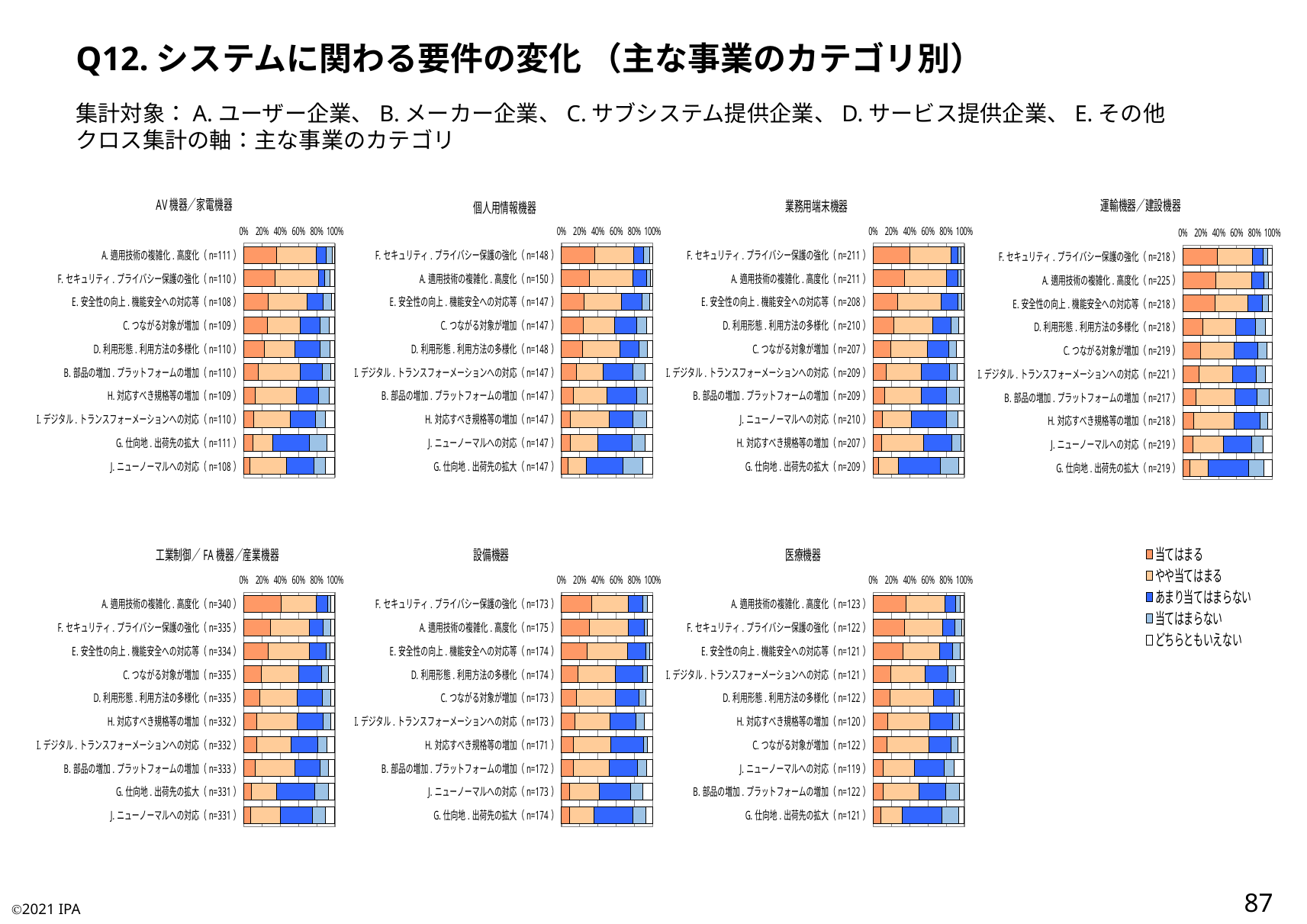
In the AV機器／家電機器 chart, is the 当てはまる share for G. 仕向地.出荷先の拡大 greater or less than 20%? less What is the first entry in the legend? 当てはまる In the 医療機器 chart, what is the n value shown for J. ニューノーマルへの対応? n=119 How many categories are plotted in the 個人用情報機器 chart? 10 What kind of chart is used for the AV機器／家電機器 panel? Stacked bar chart Which category is listed at the top of the 設備機器 chart? F. セキュリティ.プライバシー保護の強化 In the 医療機器 chart, is the 当てはまる share for G. 仕向地.出荷先の拡大 greater or less than 20%? less How many series does the legend list? 5 In the 業務用端末機器 chart, what is the n value shown for I. デジタル.トランスフォーメーションへの対応? n=209 In the 工業制御／FA機器／産業機器 chart, what is the n value shown for A. 適用技術の複雑化.高度化? n=340 How many charts are shown on the slide? 7 In the 運輸機器／建設機器 chart, what is the n value shown for A. 適用技術の複雑化.高度化? n=225